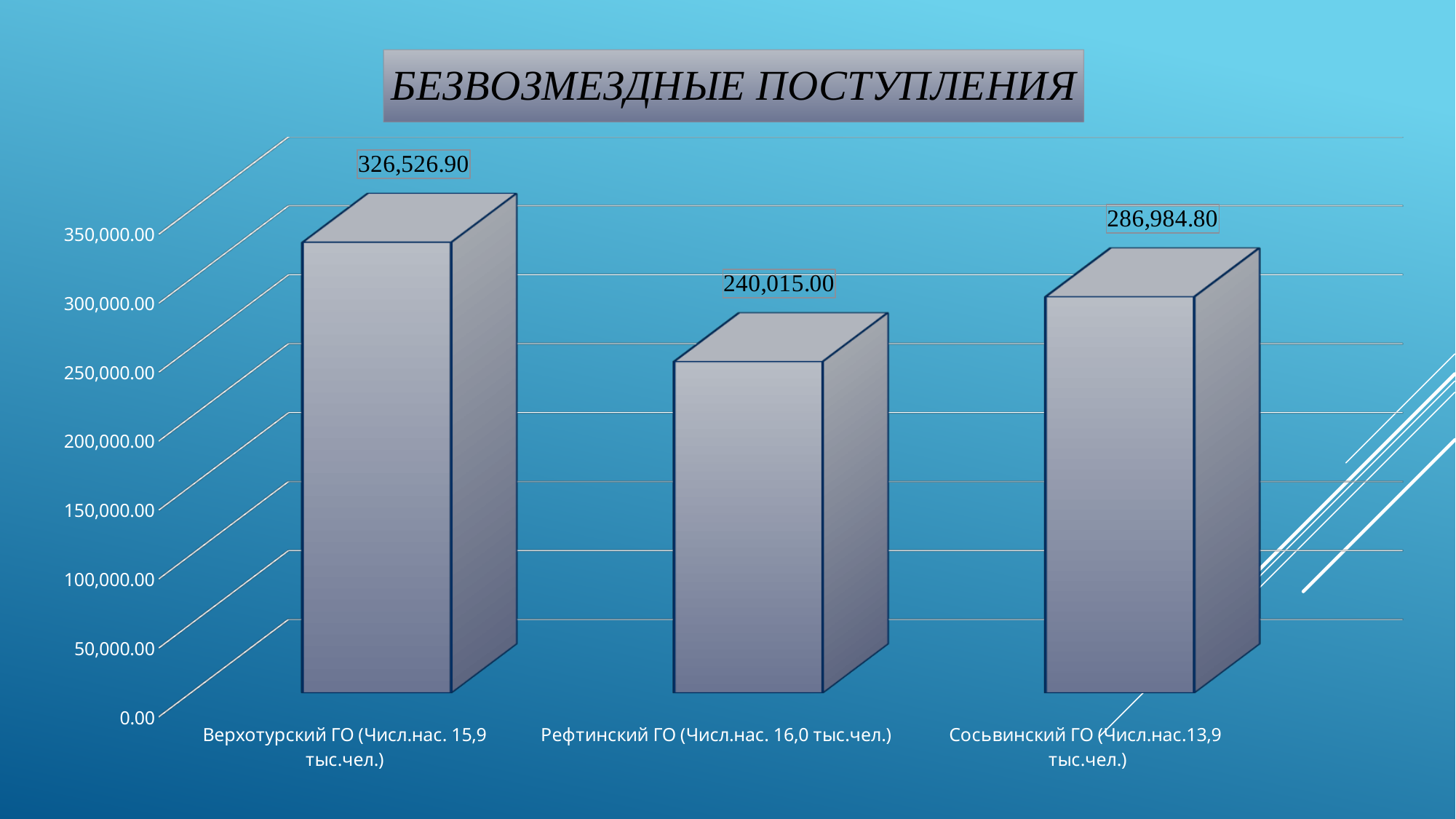
What is the title of the chart? БЕЗВОЗМЕЗДНЫЕ ПОСТУПЛЕНИЯ What is the value for Верхотурский ГО? 326,526.90 Which category has the highest value? Верхотурский ГО Which category has the lowest value? Рефтинский ГО What is the value for Рефтинский ГО? 240,015.00 What is the value for Сосьвинский ГО? 286,984.80 How many categories are shown on the chart? 3 What is the difference between the values for Верхотурский ГО and Рефтинский ГО? 86,511.90 What kind of chart is shown on the slide? bar chart What is the difference between the values for Сосьвинский ГО and Рефтинский ГО? 46,969.80 Is the value for Рефтинский ГО greater or less than 250,000.00? less Which is larger, the value for Сосьвинский ГО or the value for Рефтинский ГО? Сосьвинский ГО